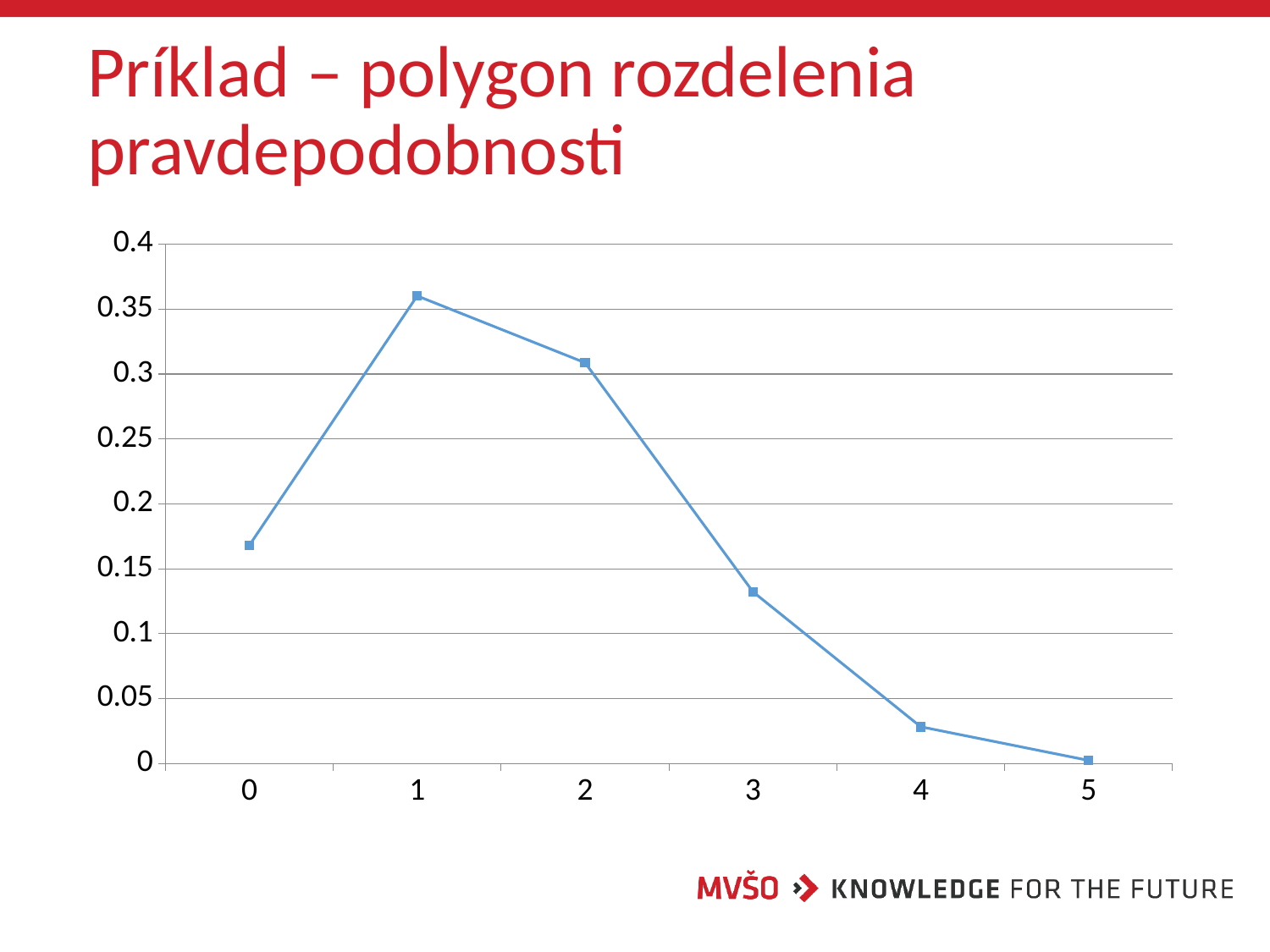
Which has the larger value, x = 0 or x = 2? 2 Is the value at x = 0 greater or less than 0.2? less Is the value at x = 2 greater or less than 0.3? greater At which x value does the line reach its lowest point? 5 How many data points are plotted on the chart? 6 At which x value does the line reach its highest point? 1 Is the value at x = 3 greater or less than 0.15? less Does the line rise or fall between x = 1 and x = 5? fall What kind of chart is shown on the slide? line chart What is the highest value shown on the vertical axis? 0.4